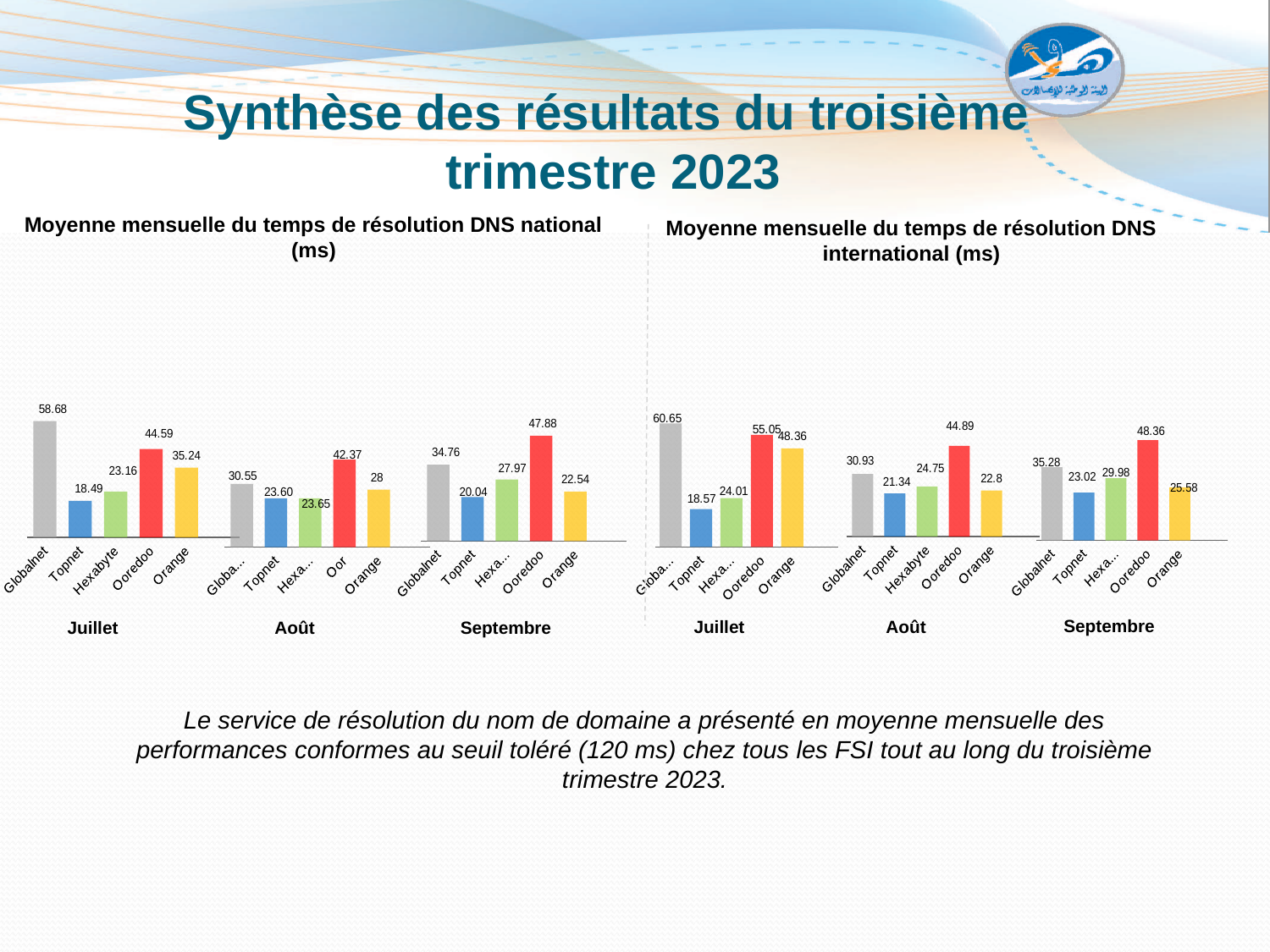
In the 'Moyenne mensuelle du temps de résolution DNS international (ms)' chart, what is the value for Orange in Août? 22.8 In the 'Moyenne mensuelle du temps de résolution DNS national (ms)' chart, what is the value for Ooredoo in Septembre? 47.88 In the 'Moyenne mensuelle du temps de résolution DNS national (ms)' chart, which provider has the lowest value in Juillet? Topnet In the 'Moyenne mensuelle du temps de résolution DNS national (ms)' chart, what is the value for Globalnet in Juillet? 58.68 In the 'Moyenne mensuelle du temps de résolution DNS international (ms)' chart, what is the difference between Ooredoo and Topnet in Septembre? 25.34 In the 'Moyenne mensuelle du temps de résolution DNS national (ms)' chart, what is the difference between Globalnet and Topnet in Juillet? 40.19 In the 'Moyenne mensuelle du temps de résolution DNS national (ms)' chart, which provider has the highest value in Septembre? Ooredoo In the 'Moyenne mensuelle du temps de résolution DNS international (ms)' chart, is the value for Ooredoo or Orange larger in Septembre? Ooredoo In the 'Moyenne mensuelle du temps de résolution DNS international (ms)' chart, how many months are shown along the x axis? 3 In the 'Moyenne mensuelle du temps de résolution DNS international (ms)' chart, what is the value for Globalnet in Juillet? 60.65 In the 'Moyenne mensuelle du temps de résolution DNS international (ms)' chart, which provider has the highest value in Août? Ooredoo In the 'Moyenne mensuelle du temps de résolution DNS national (ms)' chart, what type of chart is shown? Bar chart